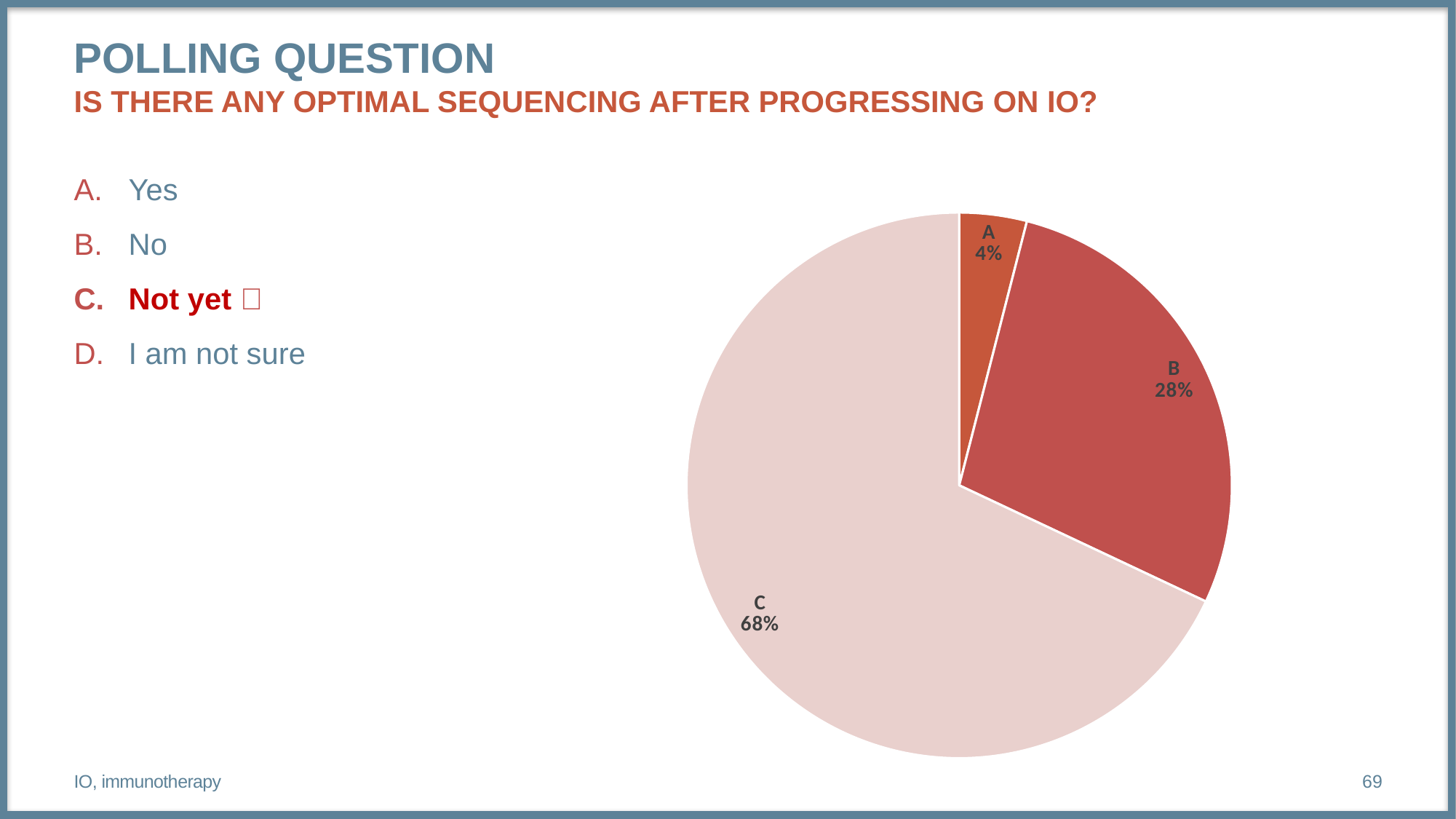
What percentage is shown for slice A? 4% What percentage is shown for slice B? 28% Which slice of the pie is the largest? C What share of the pie does slice C represent? 68% What kind of chart is shown on the slide? pie chart Which slice of the pie is the smallest? A Which is larger, slice B or slice A? B What is the difference in percentage points between slice C and slice B? 40 What percentage is shown for slice C? 68% What is the difference in percentage points between slice B and slice A? 24 Which answer option does slice C correspond to according to the list on the slide? Not yet How many slices does the pie chart have? 3